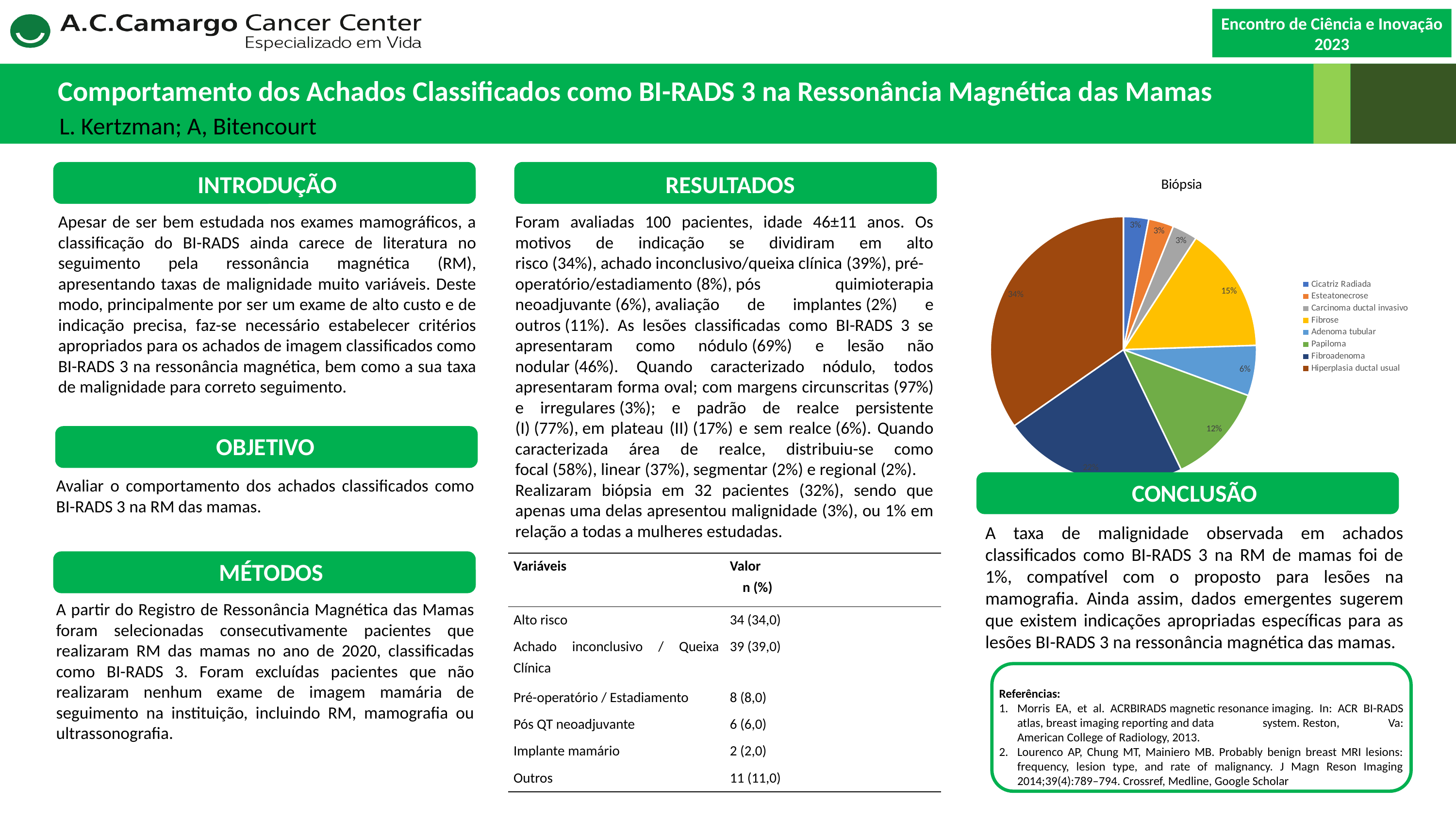
In the "Biópsia" pie chart, what share is labelled for Fibrose? 15% In the "Biópsia" pie chart, what share is labelled for Adenoma tubular? 6% In the "Biópsia" pie chart, how many percentage points larger is the Fibrose slice than the Papiloma slice? 3 In the "Biópsia" pie chart, what share is labelled for Papiloma? 12% In the "Biópsia" pie chart, what share is labelled for Cicatriz Radiada? 3% What kind of chart is the "Biópsia" chart on the slide? Pie chart What is the title of the pie chart on the slide? Biópsia In the "Biópsia" pie chart, what share is labelled for Hiperplasia ductal usual? 34% How many categories does the legend of the "Biópsia" pie chart list? 8 In the "Biópsia" pie chart, which slice is larger: Fibroadenoma or Papiloma? Fibroadenoma In the "Biópsia" pie chart, which slice is larger: Fibrose or Adenoma tubular? Fibrose Which category has the largest slice in the "Biópsia" pie chart? Hiperplasia ductal usual